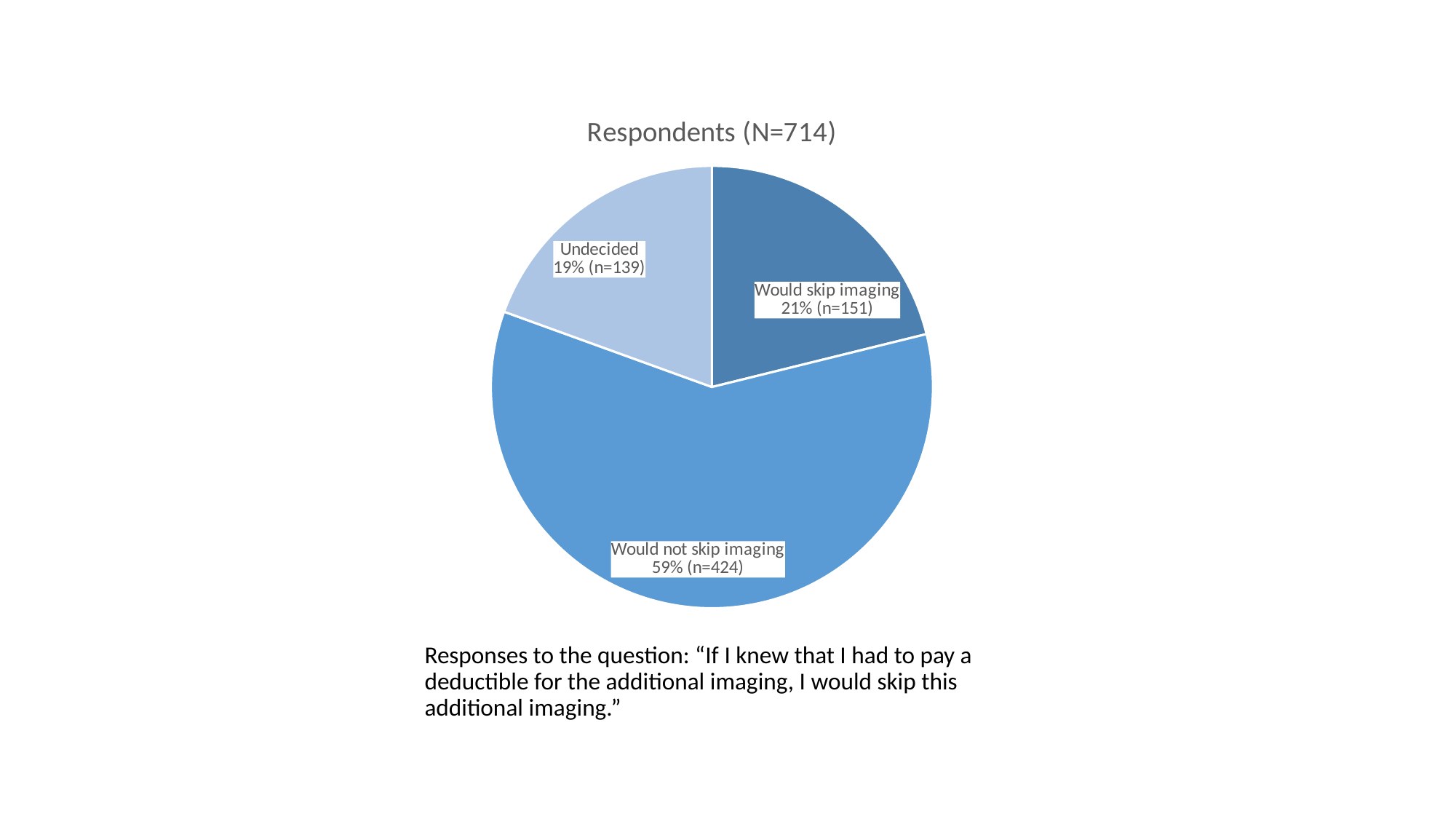
What percentage of respondents would skip imaging? 21% What is the title of the chart? Respondents (N=714) What is the share of the pie for the 'Undecided' slice? 19% What is the difference in percentage points between 'Would not skip imaging' and 'Would skip imaging'? 38 How many respondents would skip imaging? 151 What percentage of respondents would not skip imaging? 59% Which response category has the smallest share of the pie? Undecided Which response category has the largest share of the pie? Would not skip imaging How many respondents were undecided? 139 Which has more respondents: 'Would skip imaging' or 'Undecided'? Would skip imaging How many slices does the pie chart have? 3 What kind of chart is shown on the slide? pie chart